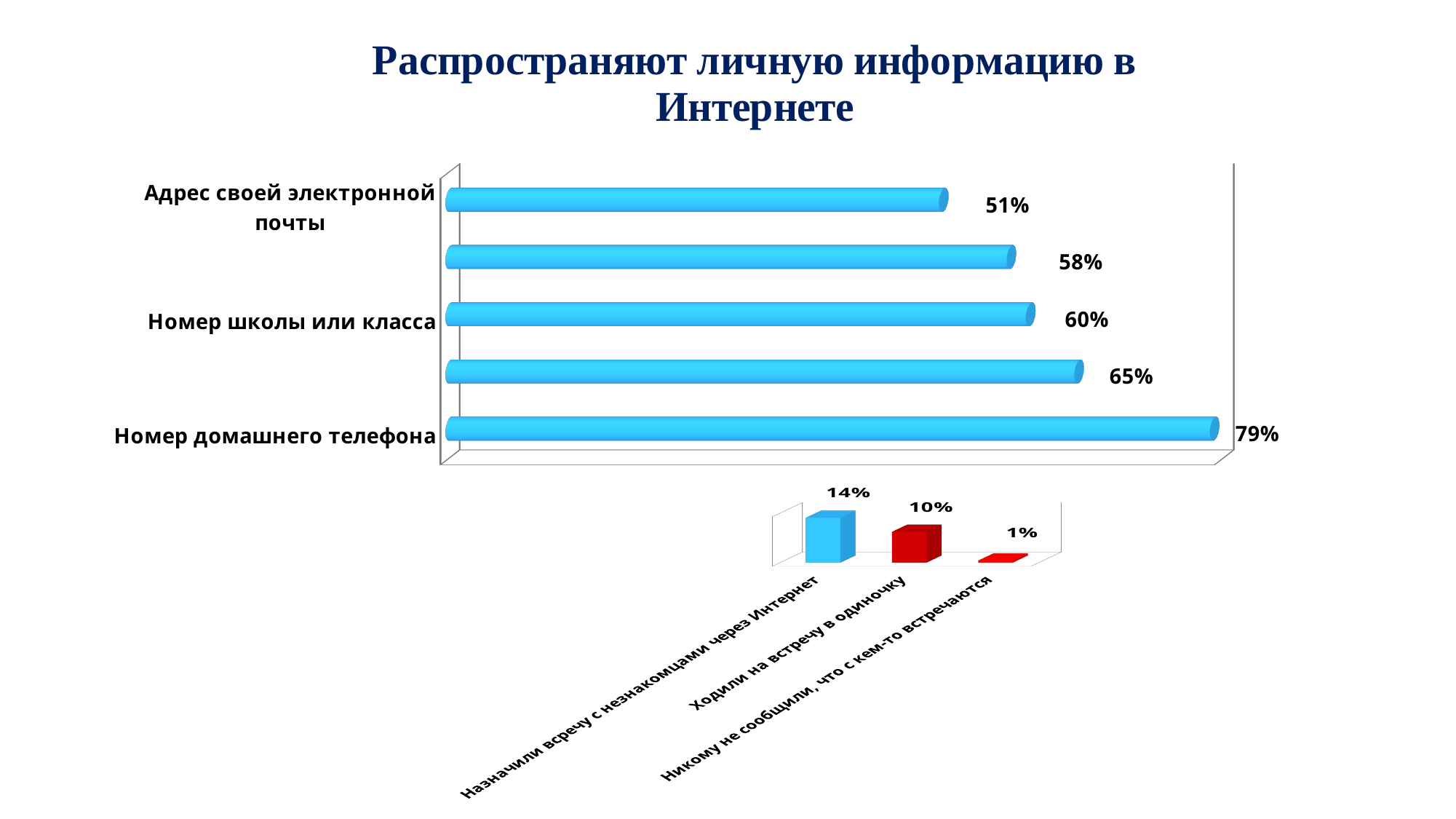
In the top chart 'Распространяют личную информацию в Интернете', what is the value for 'Адрес своей электронной почты'? 51% In the bottom chart, which category has the highest value? Назначили всречу с незнакомцами через Интернет In the top chart 'Распространяют личную информацию в Интернете', what is the difference between the values for 'Номер домашнего телефона' and 'Адрес своей электронной почты'? 28% In the top chart 'Распространяют личную информацию в Интернете', which labelled category has the lowest value? Адрес своей электронной почты In the top chart 'Распространяют личную информацию в Интернете', what is the value for 'Номер школы или класса'? 60% In the top chart 'Распространяют личную информацию в Интернете', which labelled category has the highest value? Номер домашнего телефона In the top chart 'Распространяют личную информацию в Интернете', what is the value for 'Номер домашнего телефона'? 79% In the bottom chart, what is the value for 'Никому не сообщили, что с кем-то встречаются'? 1% In the bottom chart, what is the value for 'Ходили на встречу в одиночку'? 10% What kind of chart is the top chart 'Распространяют личную информацию в Интернете'? bar chart In the top chart 'Распространяют личную информацию в Интернете', how many bars are plotted? 5 In the bottom chart, what is the difference between the values for 'Назначили всречу с незнакомцами через Интернет' and 'Ходили на встречу в одиночку'? 4%